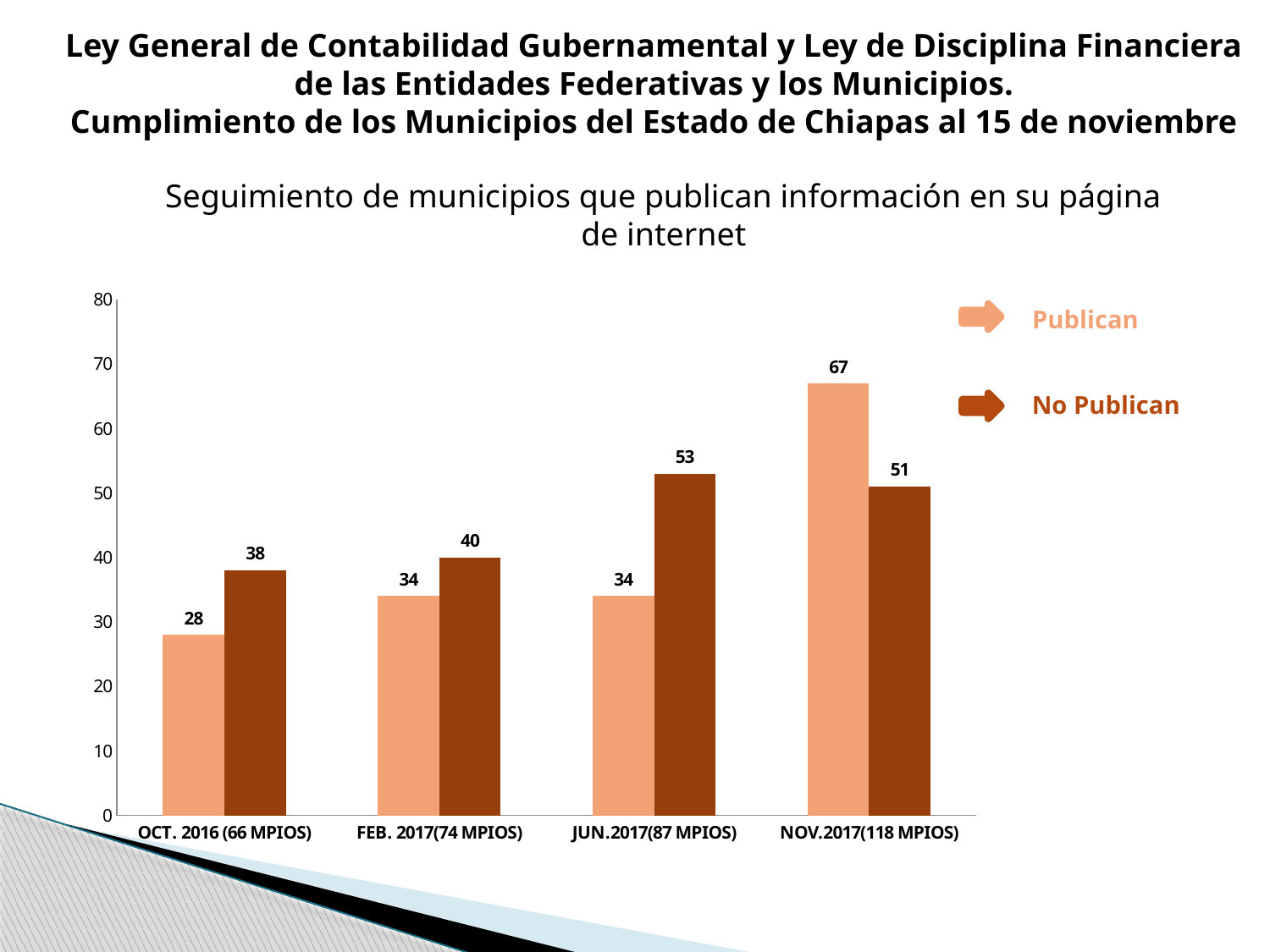
What is the value for No Publican in JUN.2017(87 MPIOS)? 53 What is the value for Publican in NOV.2017(118 MPIOS)? 67 What is the value for Publican in OCT. 2016 (66 MPIOS)? 28 What is the difference between No Publican and Publican in FEB. 2017(74 MPIOS)? 6 How many series does the legend list? 2 What kind of chart is shown? bar chart Does the Publican series rise or fall from OCT. 2016 to NOV.2017? rise Which is larger in NOV.2017(118 MPIOS), Publican or No Publican? Publican In which period is the Publican value highest? NOV.2017(118 MPIOS) Is the value for No Publican in JUN.2017(87 MPIOS) greater or less than 50? greater In which period is the No Publican value lowest? OCT. 2016 (66 MPIOS) How many periods are shown on the x axis? 4